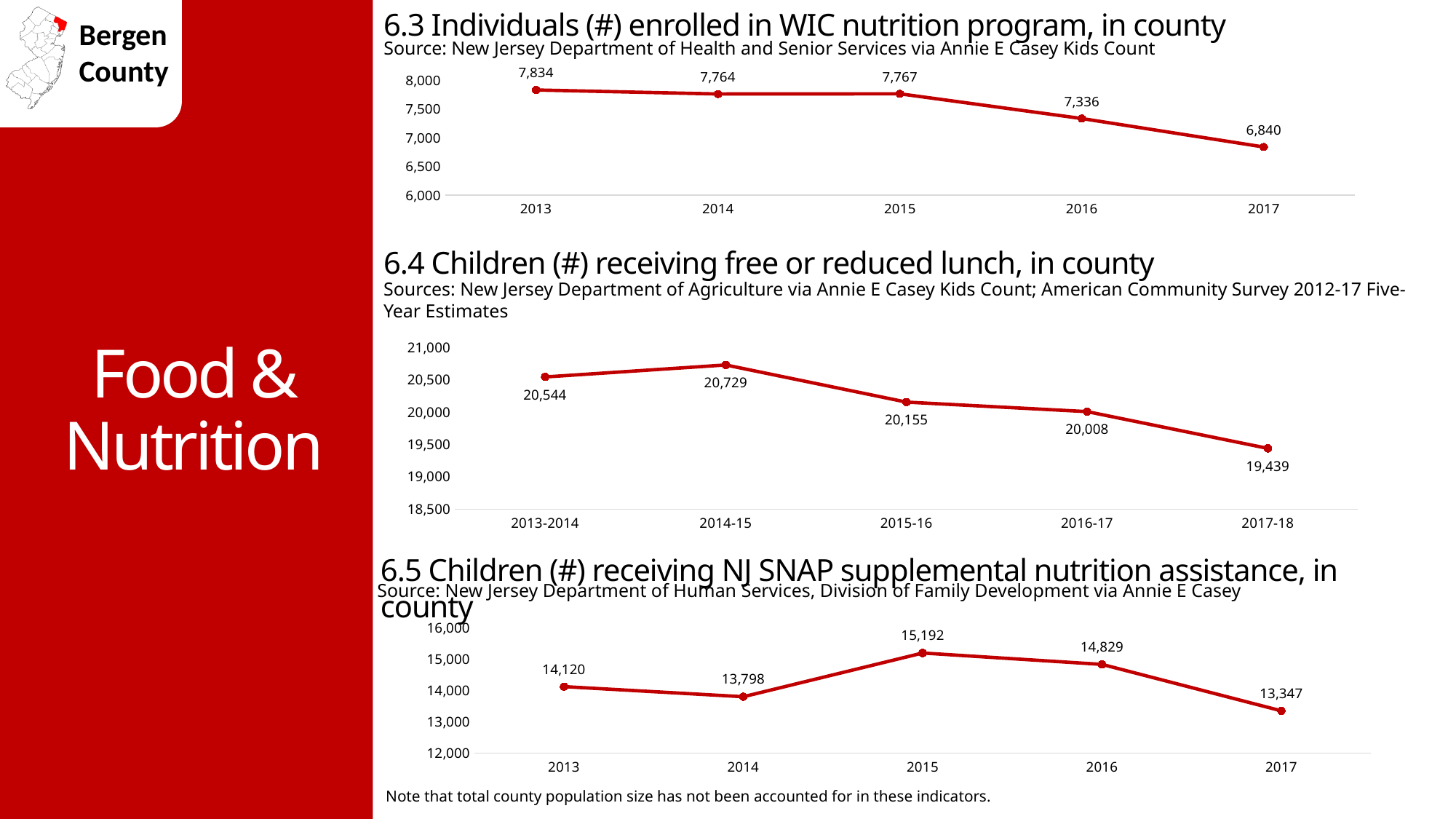
In the chart '6.3 Individuals (#) enrolled in WIC nutrition program, in county', what is the difference between the 2016 and 2017 values? 496 In the chart '6.5 Children (#) receiving NJ SNAP supplemental nutrition assistance, in county', what is the value for 2015? 15,192 In the chart '6.5 Children (#) receiving NJ SNAP supplemental nutrition assistance, in county', which is larger, the value for 2013 or the value for 2014? 2013 What kind of chart is '6.3 Individuals (#) enrolled in WIC nutrition program, in county'? line chart In the chart '6.5 Children (#) receiving NJ SNAP supplemental nutrition assistance, in county', what is the difference between the 2015 and 2017 values? 1,845 In the chart '6.5 Children (#) receiving NJ SNAP supplemental nutrition assistance, in county', do the values rise or fall from 2015 to 2017? fall In the chart '6.3 Individuals (#) enrolled in WIC nutrition program, in county', which year has the lowest value? 2017 In the chart '6.4 Children (#) receiving free or reduced lunch, in county', which school year has the highest value? 2014-15 In the chart '6.4 Children (#) receiving free or reduced lunch, in county', is the value for 2017-18 greater or less than 19,500? less In the chart '6.4 Children (#) receiving free or reduced lunch, in county', what is the value for 2014-15? 20,729 In the chart '6.4 Children (#) receiving free or reduced lunch, in county', how many data points are plotted? 5 In the chart '6.3 Individuals (#) enrolled in WIC nutrition program, in county', what is the value for 2013? 7,834